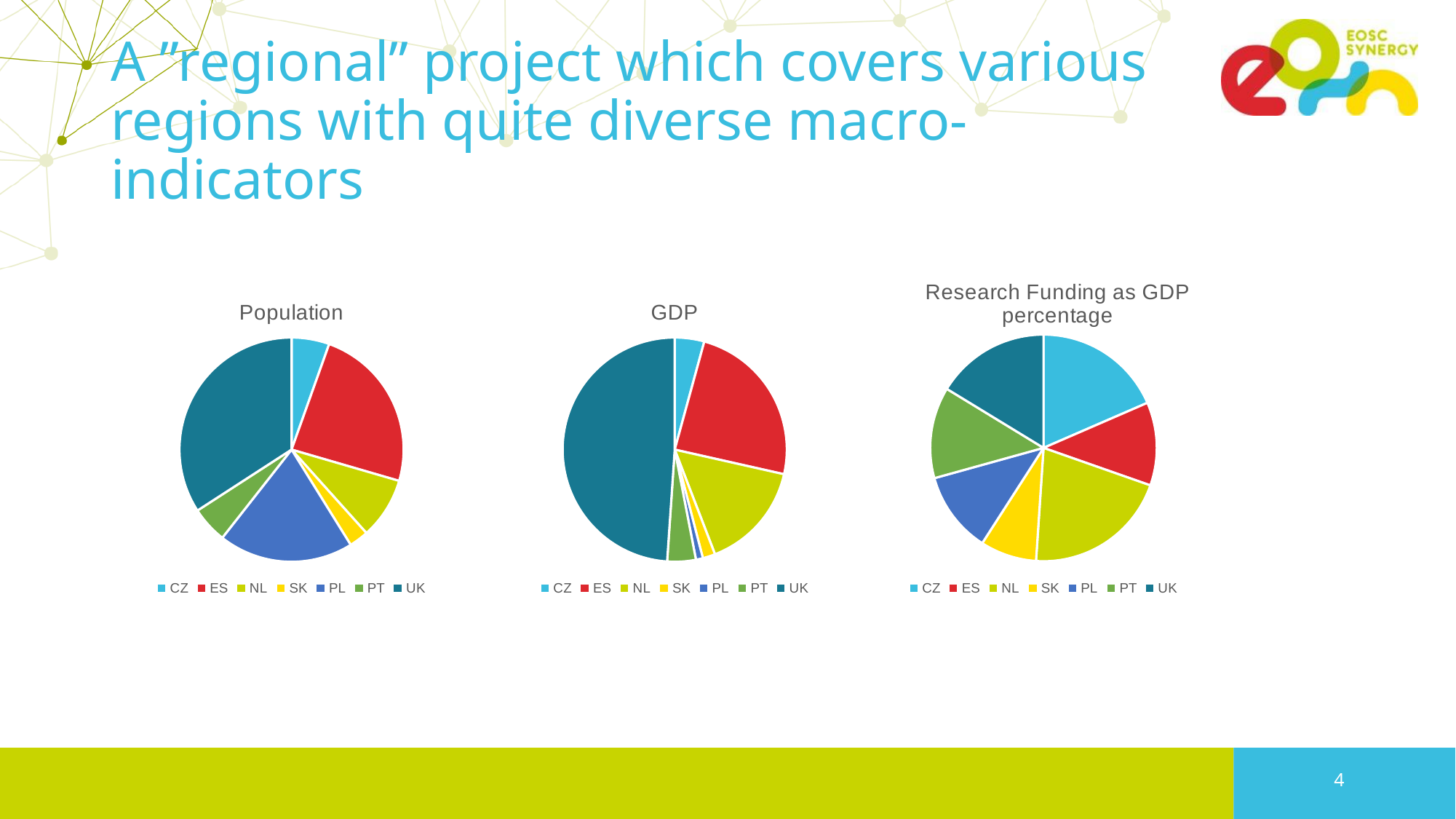
In the GDP chart, which country has the largest slice? UK What kind of chart is the Population chart? pie chart In the Population chart, which country has the smallest slice? SK In the GDP chart, which slice is larger, UK or ES? UK In the Population chart, which country has the largest slice? UK In the GDP chart, which country has the smallest slice? PL How many countries does the legend of the GDP chart list? 7 In the Population chart, which slice is larger, PL or PT? PL In the Research Funding as GDP percentage chart, which slice is larger, NL or PL? NL How many charts are shown on the slide? 3 In the Research Funding as GDP percentage chart, which country has the largest slice? NL What is the title of the rightmost chart? Research Funding as GDP percentage